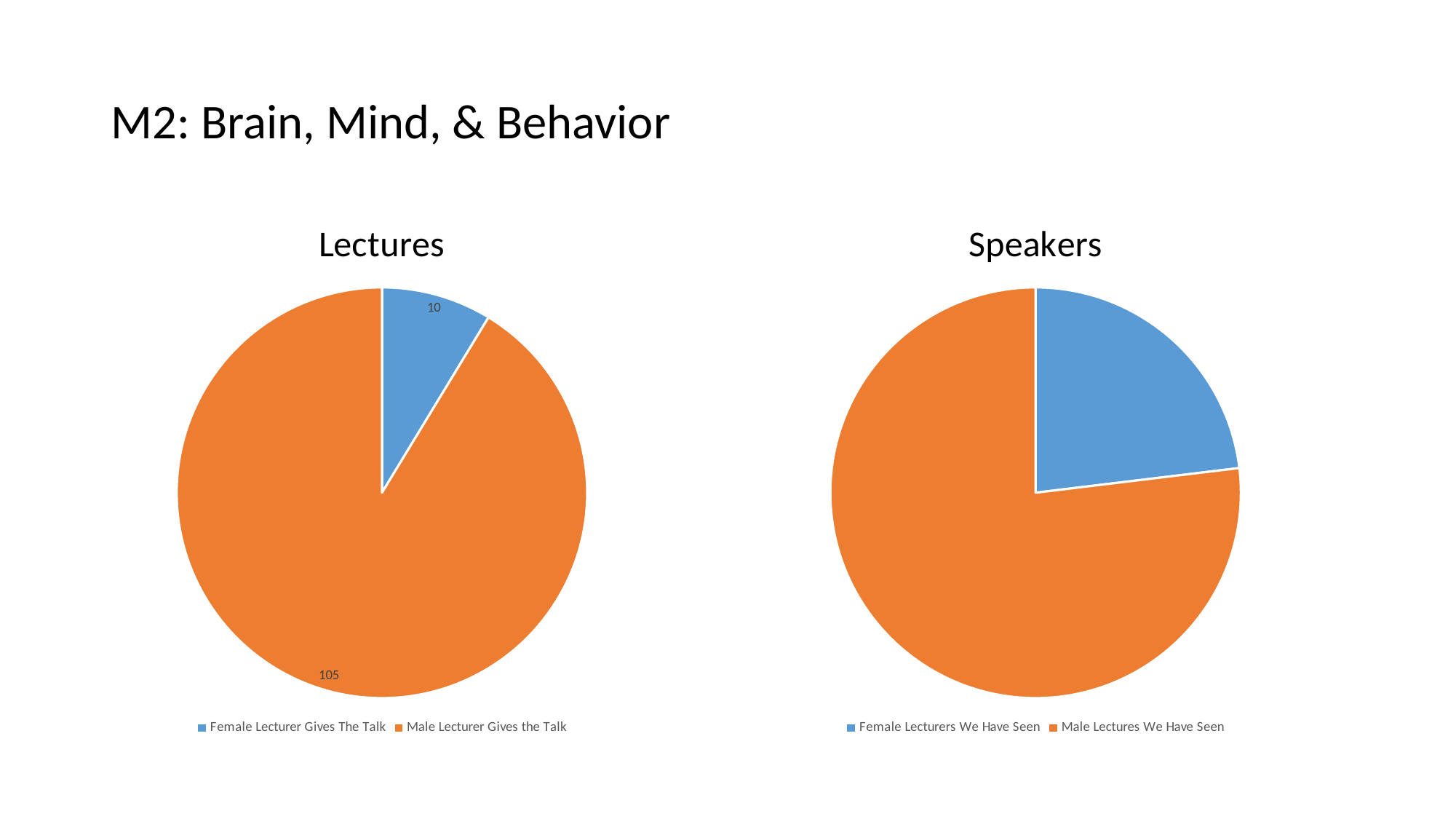
In the Lectures chart, what colour is the Female Lecturer Gives The Talk slice? Blue In the Lectures chart, which category has the largest slice? Male Lecturer Gives the Talk In the Lectures chart, what share of the pie is Female Lecturer Gives The Talk? 8.7% In the Lectures chart, what is the total of the two slices? 115 In the Lectures chart, what is the value for Female Lecturer Gives The Talk? 10 How many categories does the legend of the Speakers chart list? 2 What kind of chart is the Speakers chart? Pie chart In the Speakers chart, which category has the larger slice? Male Lectures We Have Seen In the Lectures chart, which category has the smallest slice? Female Lecturer Gives The Talk In the Lectures chart, what is the value for Male Lecturer Gives the Talk? 105 In the Speakers chart, which is larger: Female Lecturers We Have Seen or Male Lectures We Have Seen? Male Lectures We Have Seen In the Lectures chart, what is the difference between the Male Lecturer Gives the Talk value and the Female Lecturer Gives The Talk value? 95